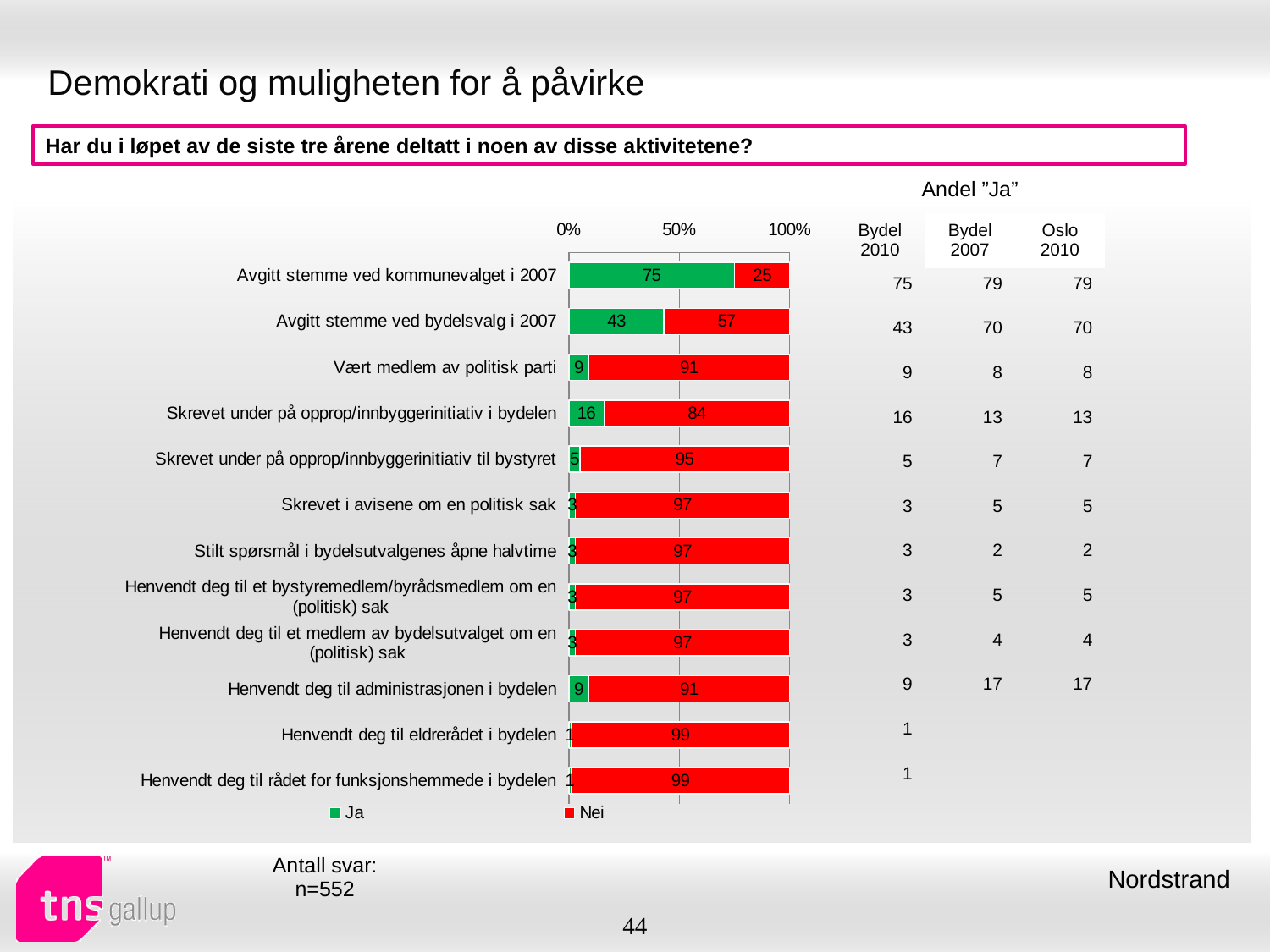
Which category has the highest 'Nei' value? Henvendt deg til eldrerådet i bydelen and Henvendt deg til rådet for funksjonshemmede i bydelen (99) What is the difference between the 'Ja' values for 'Avgitt stemme ved kommunevalget i 2007' and 'Avgitt stemme ved bydelsvalg i 2007'? 32 What is the 'Ja' value for 'Skrevet under på opprop/innbyggerinitiativ i bydelen'? 16 How many series does the chart legend list? 2 What is the 'Nei' value for 'Avgitt stemme ved bydelsvalg i 2007'? 57 What is the 'Ja' value for 'Avgitt stemme ved kommunevalget i 2007'? 75 Which category has the highest 'Ja' value? Avgitt stemme ved kommunevalget i 2007 Which colour represents the 'Nei' series in the chart? red What kind of chart is shown on the slide? stacked bar chart Which is larger: the 'Ja' value for 'Vært medlem av politisk parti' or for 'Skrevet under på opprop/innbyggerinitiativ i bydelen'? Skrevet under på opprop/innbyggerinitiativ i bydelen What is the total of the stacked bar for 'Avgitt stemme ved kommunevalget i 2007'? 100 How many categories (activities) are plotted in the chart? 12